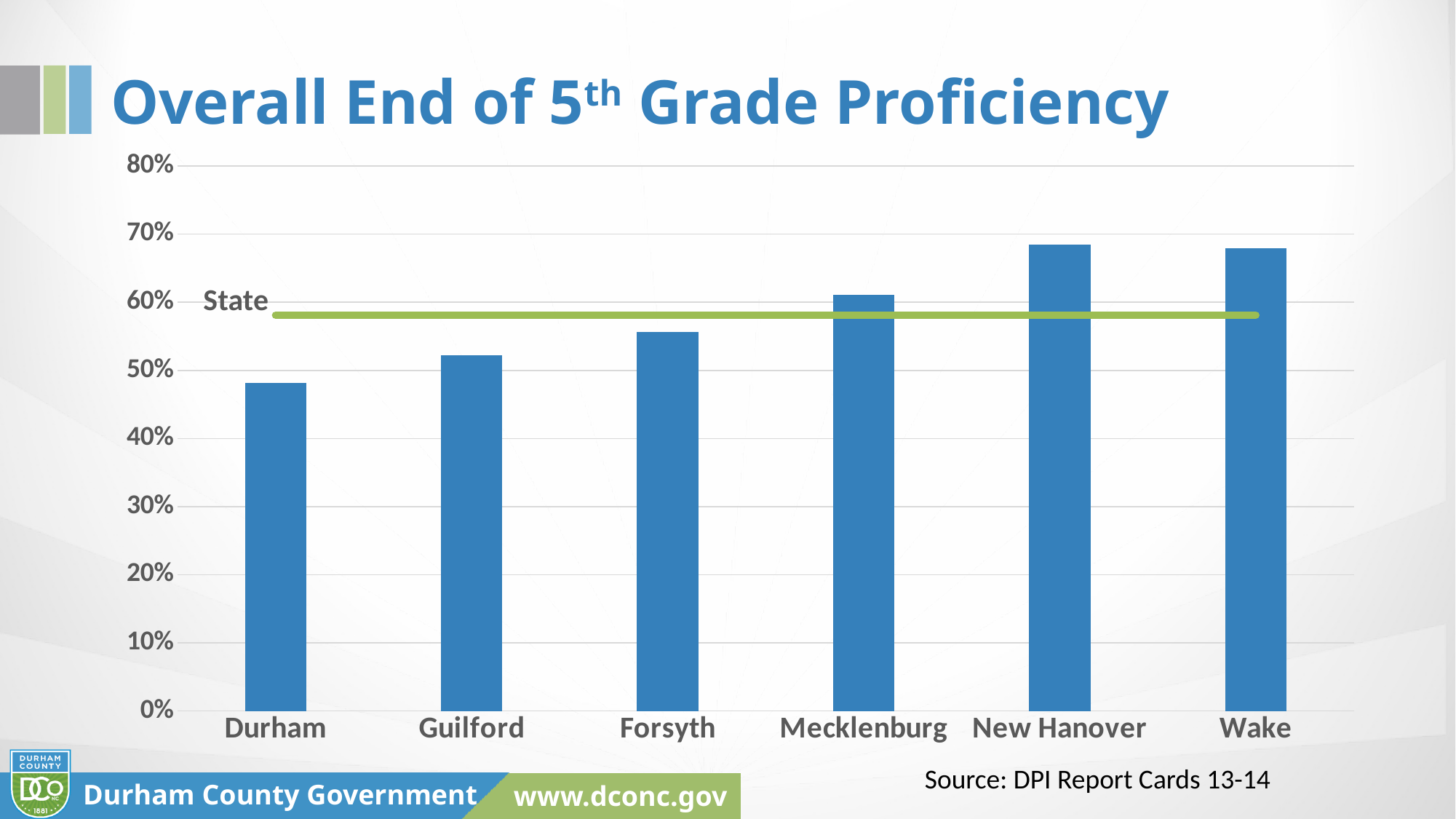
Is the value for Guilford greater or less than 50%? greater What does the green horizontal line on the chart represent? State What is the title of the chart? Overall End of 5th Grade Proficiency How many counties are shown on the x axis of the chart? 6 Is the value for Forsyth greater or less than 60%? less Is the value for Wake greater or less than 70%? less Which county has the lowest end of 5th grade proficiency? Durham Which is larger, the value for Durham or the value for Guilford? Guilford What kind of chart is shown on the slide? bar chart Which is larger, the value for Forsyth or the value for Mecklenburg? Mecklenburg